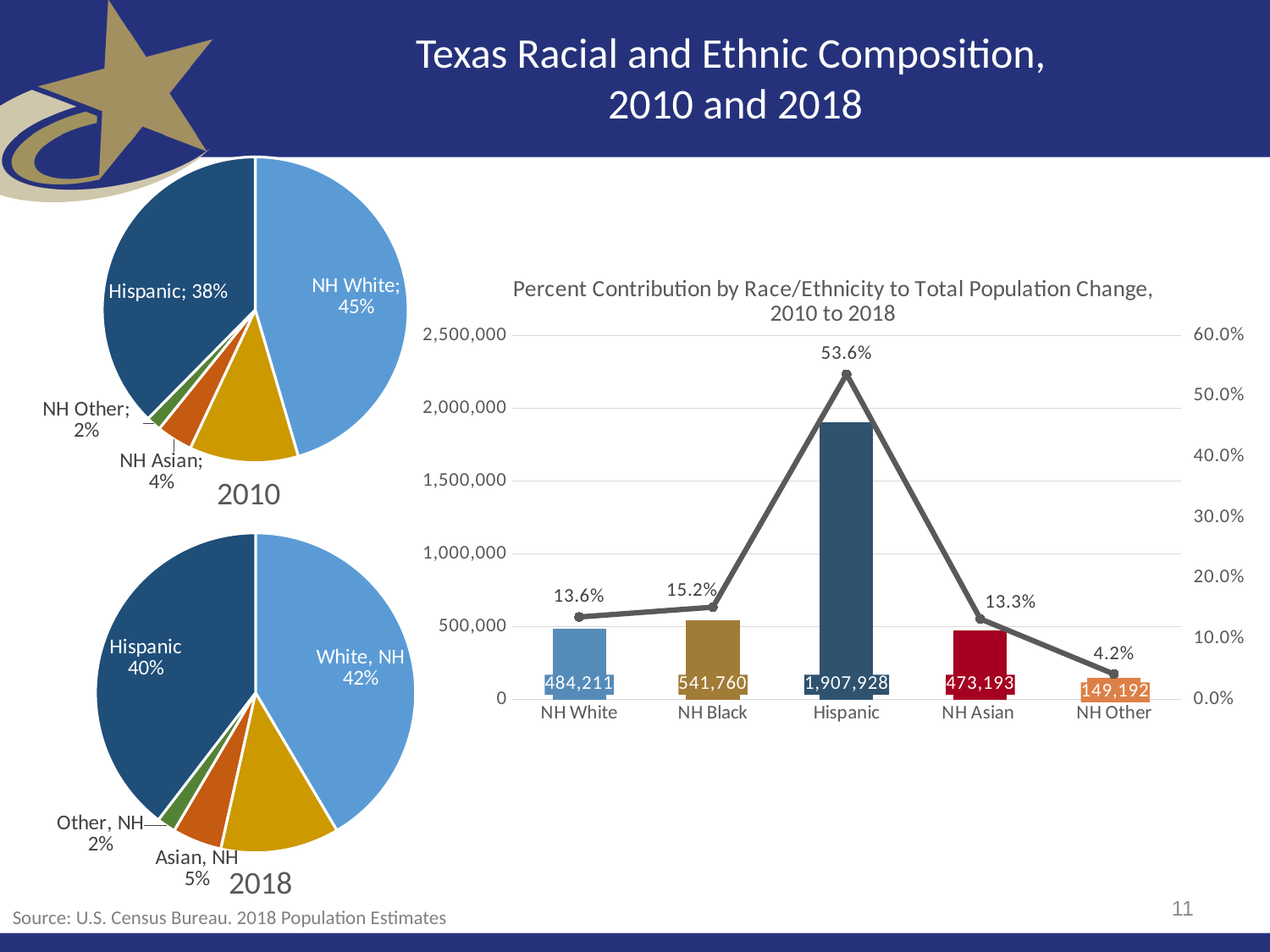
In the 'Percent Contribution by Race/Ethnicity to Total Population Change, 2010 to 2018' chart, what is the bar value for NH Other? 149,192 In the 'Percent Contribution by Race/Ethnicity to Total Population Change, 2010 to 2018' chart, what percent contribution is shown for NH Black? 15.2% In the 'Percent Contribution by Race/Ethnicity to Total Population Change, 2010 to 2018' chart, how many categories are shown on the x axis? 5 In the 2018 pie chart, what share of the population is Asian, NH? 5% In the 2018 pie chart, what is the difference between the White, NH share and the Hispanic share? 2% In the 'Percent Contribution by Race/Ethnicity to Total Population Change, 2010 to 2018' chart, what is the bar value for Hispanic? 1,907,928 In the 'Percent Contribution by Race/Ethnicity to Total Population Change, 2010 to 2018' chart, which category has the highest bar? Hispanic In the 2018 pie chart, what share of the population is Hispanic? 40% In the 2010 pie chart, what share of the population is NH White? 45% In the 2010 pie chart, which labelled slice is the smallest? NH Other In the 'Percent Contribution by Race/Ethnicity to Total Population Change, 2010 to 2018' chart, which bar is larger, NH White or NH Black? NH Black In the 2010 pie chart, which labelled slice is the largest? NH White